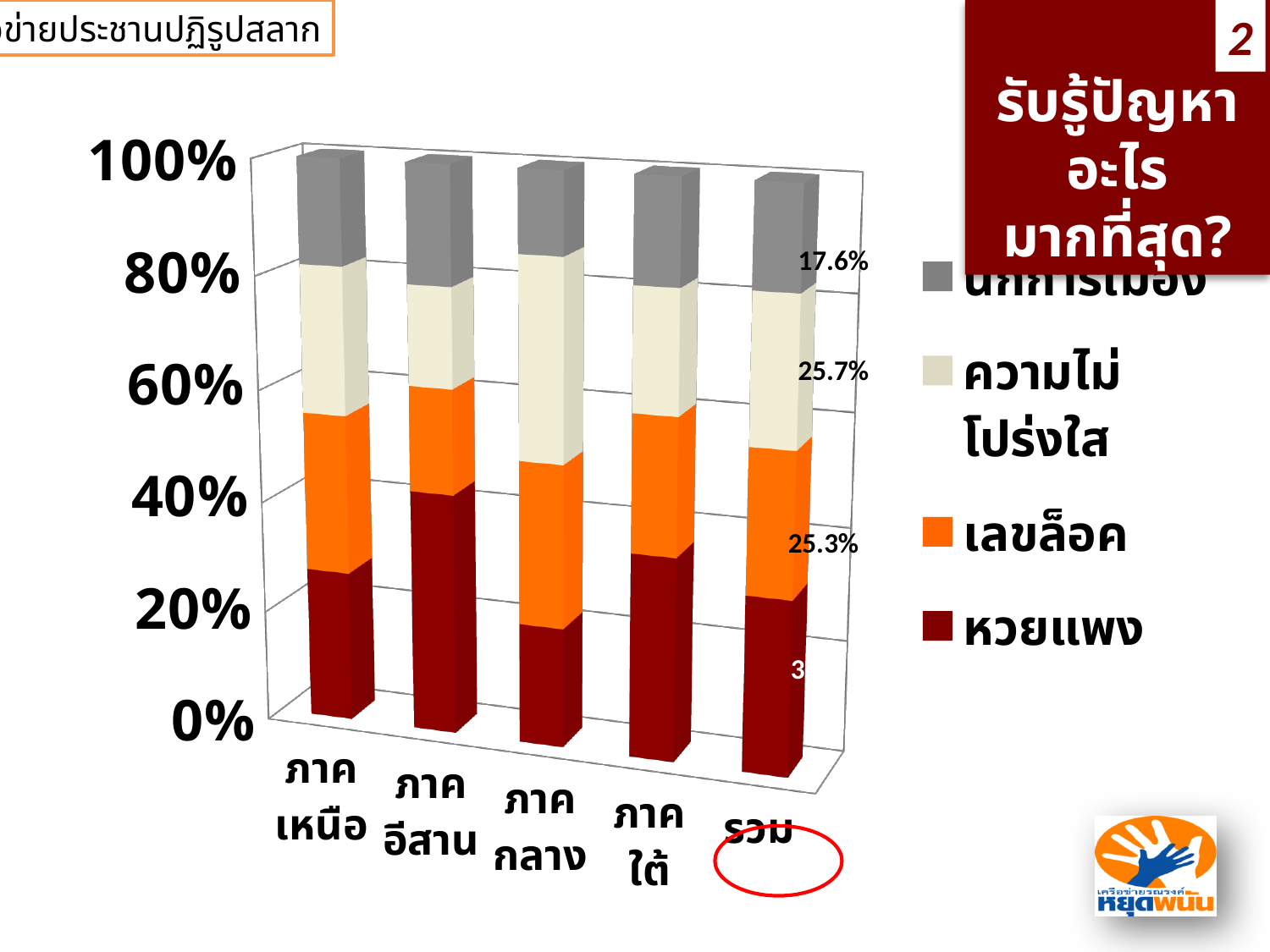
What colour represents หวยแพง in the chart legend? dark red How many categories are shown along the x axis of the chart? 5 For รวม, what is the difference between ความไม่โปร่งใส and นักการเมือง? 8.1% What is the value of นักการเมือง for รวม? 17.6% For รวม, which is larger: ความไม่โปร่งใส or นักการเมือง? ความไม่โปร่งใส What is the value of ความไม่โปร่งใส for รวม? 25.7% Is the หวยแพง value for ภาคอีสาน greater or less than 20%? greater Which region has the largest หวยแพง segment? ภาคอีสาน Which category label on the x axis is circled in red? รวม How many series does the chart legend list? 4 What is the value of เลขล็อค for รวม? 25.3% What kind of chart is shown on the slide? stacked bar chart